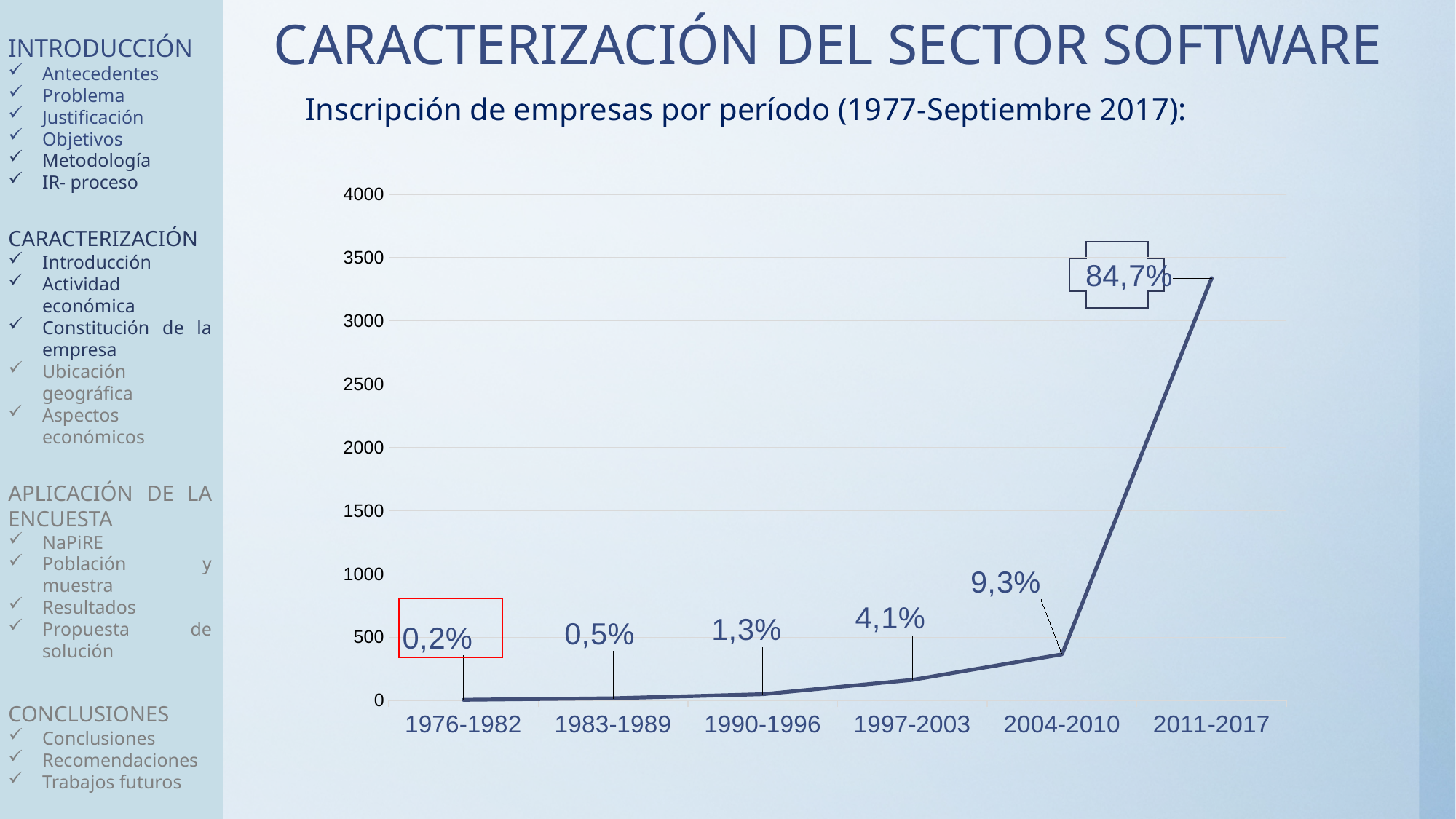
What percentage label is shown for the period 2004-2010? 9,3% What percentage label is shown for the period 1976-1982? 0,2% Do the values rise or fall from 1976-1982 to 2011-2017? rise Is the value for 2011-2017 greater or less than 3000? greater Which period has the lowest value in the chart? 1976-1982 How many periods are plotted along the x axis of the chart? 6 What kind of chart is shown on the slide? line chart What percentage label is shown for the period 2011-2017? 84,7% What percentage label is shown for the period 1997-2003? 4,1% Which period has the highest value in the chart? 2011-2017 What percentage label is shown for the period 1983-1989? 0,5% Is the value for 2004-2010 greater or less than 500? less